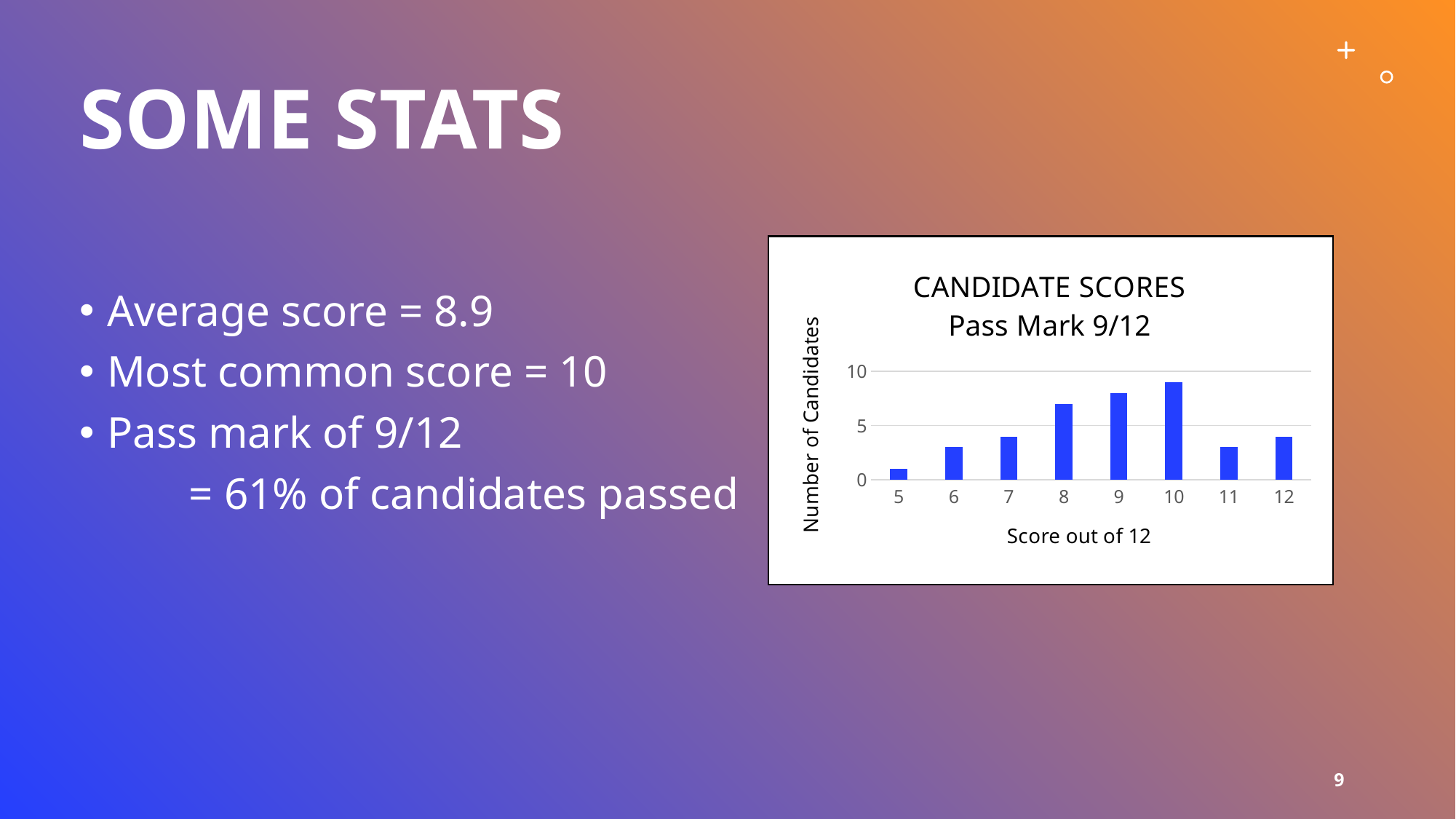
How many score categories are shown on the x axis of the chart? 8 Which score has the highest number of candidates? 10 What is the label of the vertical axis of the chart? Number of Candidates Moving along the x axis from a score of 5 to a score of 10, do the bar values rise or fall? rise Is the number of candidates for a score of 11 greater or less than 5? less What kind of chart is shown on the slide? Bar chart Which score has the lowest number of candidates? 5 Which score has more candidates, 9 or 11? 9 Is the number of candidates for a score of 8 greater or less than 5? greater Is the number of candidates for a score of 6 greater or less than 5? less What is the title of the chart? CANDIDATE SCORES Pass Mark 9/12